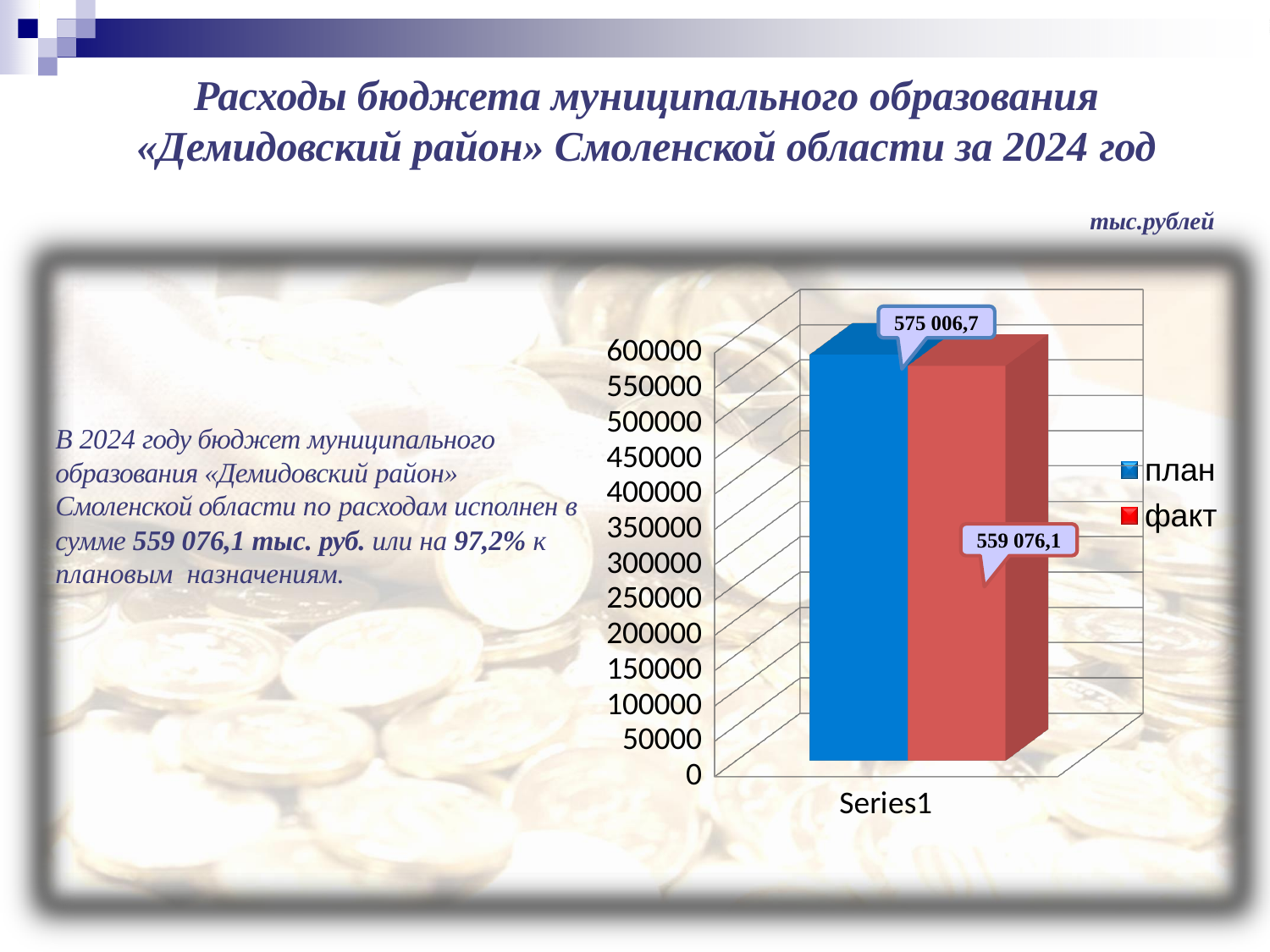
What is the value of the план (plan) bar? 575 006,7 What is the difference between the план and факт values? 15 930,6 What unit is indicated for the chart values? тыс.рублей Is the value for план greater or less than 550000? greater Is the value for факт greater or less than 600000? less How many series does the legend list? 2 How many categories are shown on the x axis of the chart? 1 What kind of chart is shown on the slide? bar chart What is the value of the факт (actual) bar? 559 076,1 What colour is the факт bar? red Which series has the lowest value on the chart? факт Which series has the higher value, план or факт? план